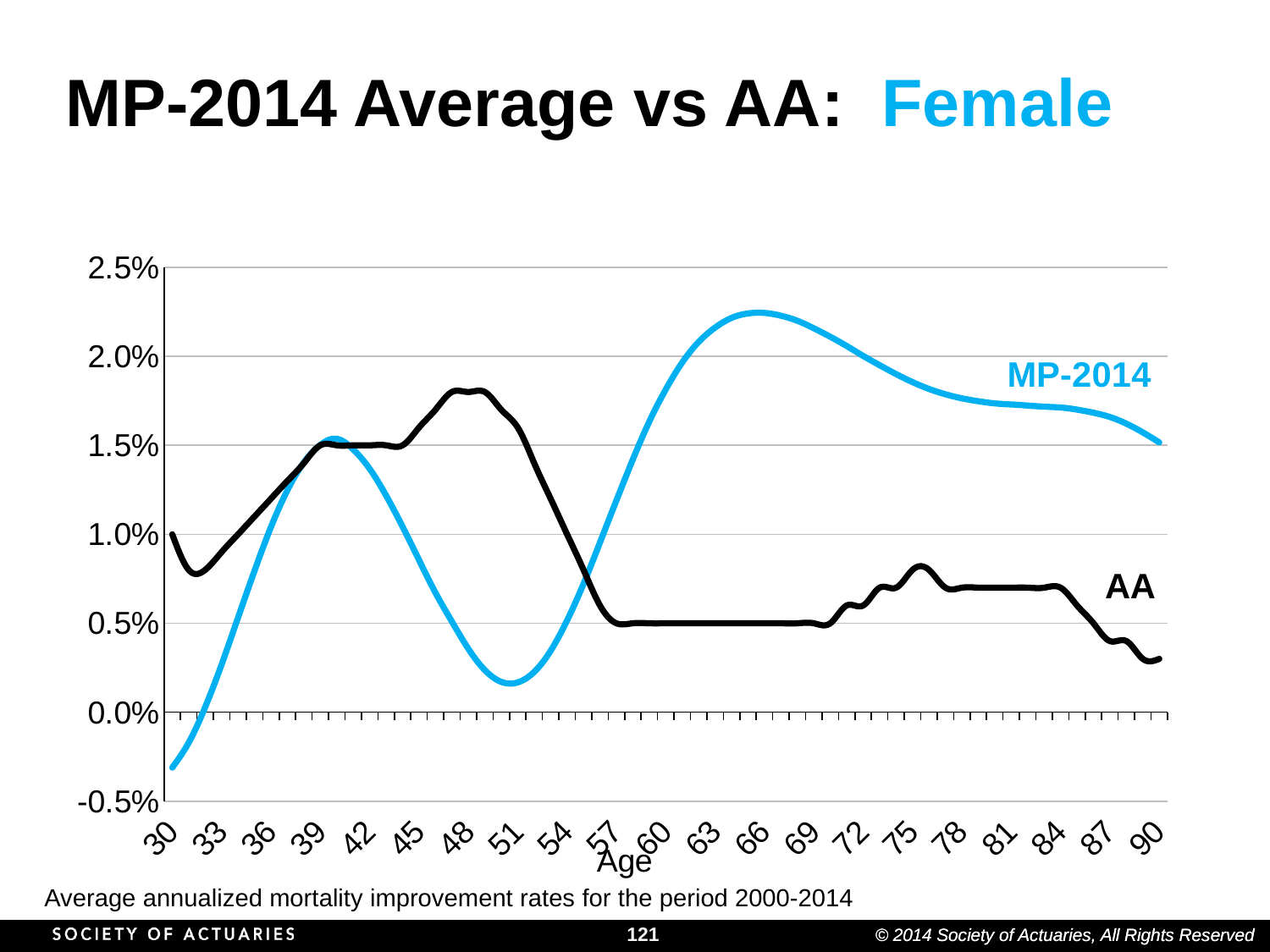
At age 48, which series has the higher value, MP-2014 or AA? AA Is the MP-2014 value at age 30 greater or less than 0.0%? less At age 66, which series has the higher value, MP-2014 or AA? MP-2014 What kind of chart is shown on the slide? line chart Is the MP-2014 value at age 66 greater or less than 2.0%? greater What is the title of the x axis? Age Does the MP-2014 line rise or fall between age 66 and age 90? fall Is the MP-2014 value at age 51 greater or less than 0.5%? less How many series are plotted on the chart? 2 Which series is drawn in blue? MP-2014